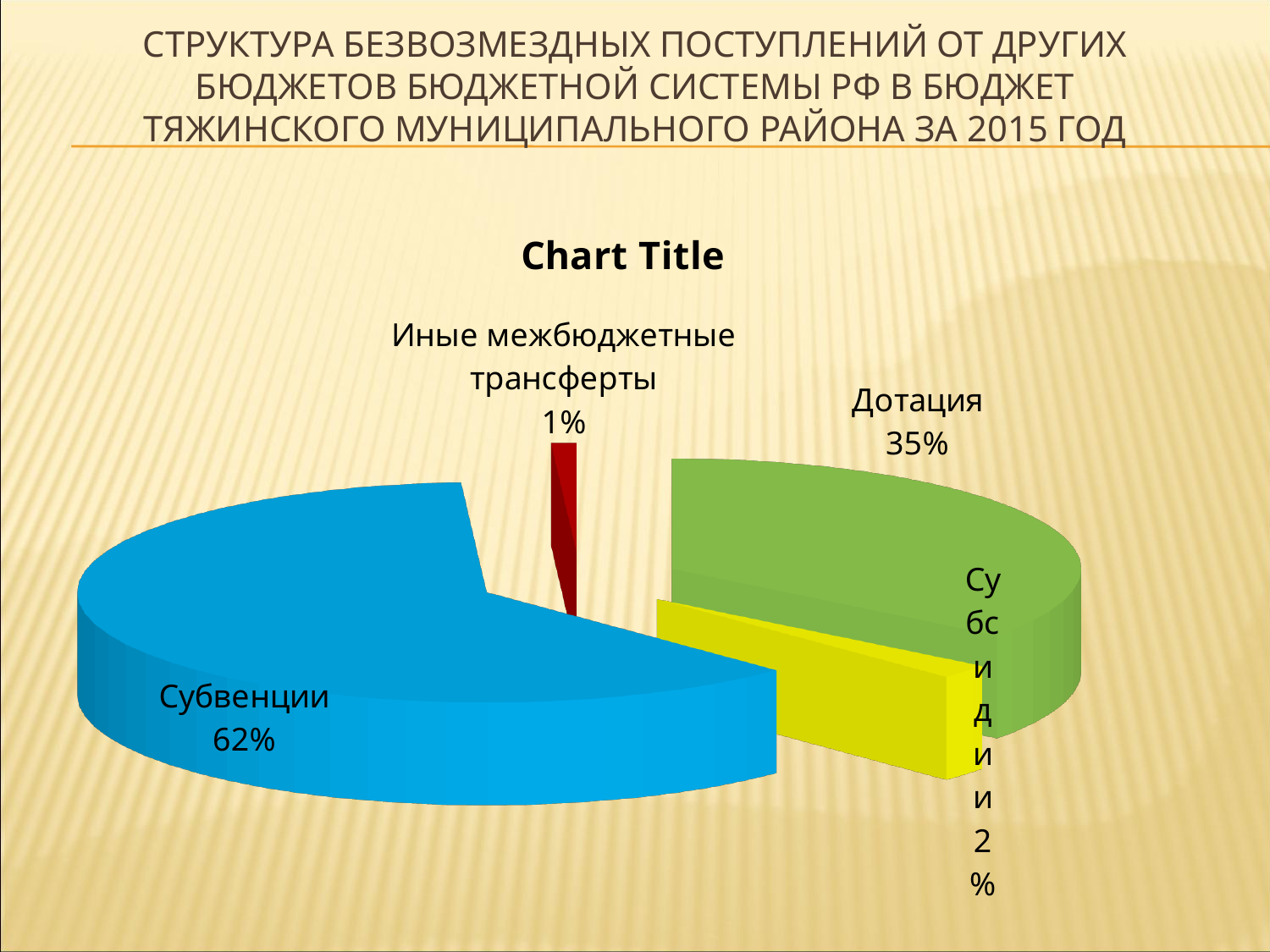
Which category has the largest slice of the pie? Субвенции What is the title printed above the chart? Chart Title What colour is the Субвенции slice? Blue How many slices does the pie chart have? 4 What share of the pie does Субвенции account for? 62% Which is larger, the share for Дотация or the share for Субсидии? Дотация What share of the pie does Дотация account for? 35% Which category has the smallest slice of the pie? Иные межбюджетные трансферты What share of the pie does Иные межбюджетные трансферты account for? 1% What is the difference in percentage points between Субвенции and Дотация? 27 What share of the pie does Субсидии account for? 2% What kind of chart is shown on the slide? Pie chart